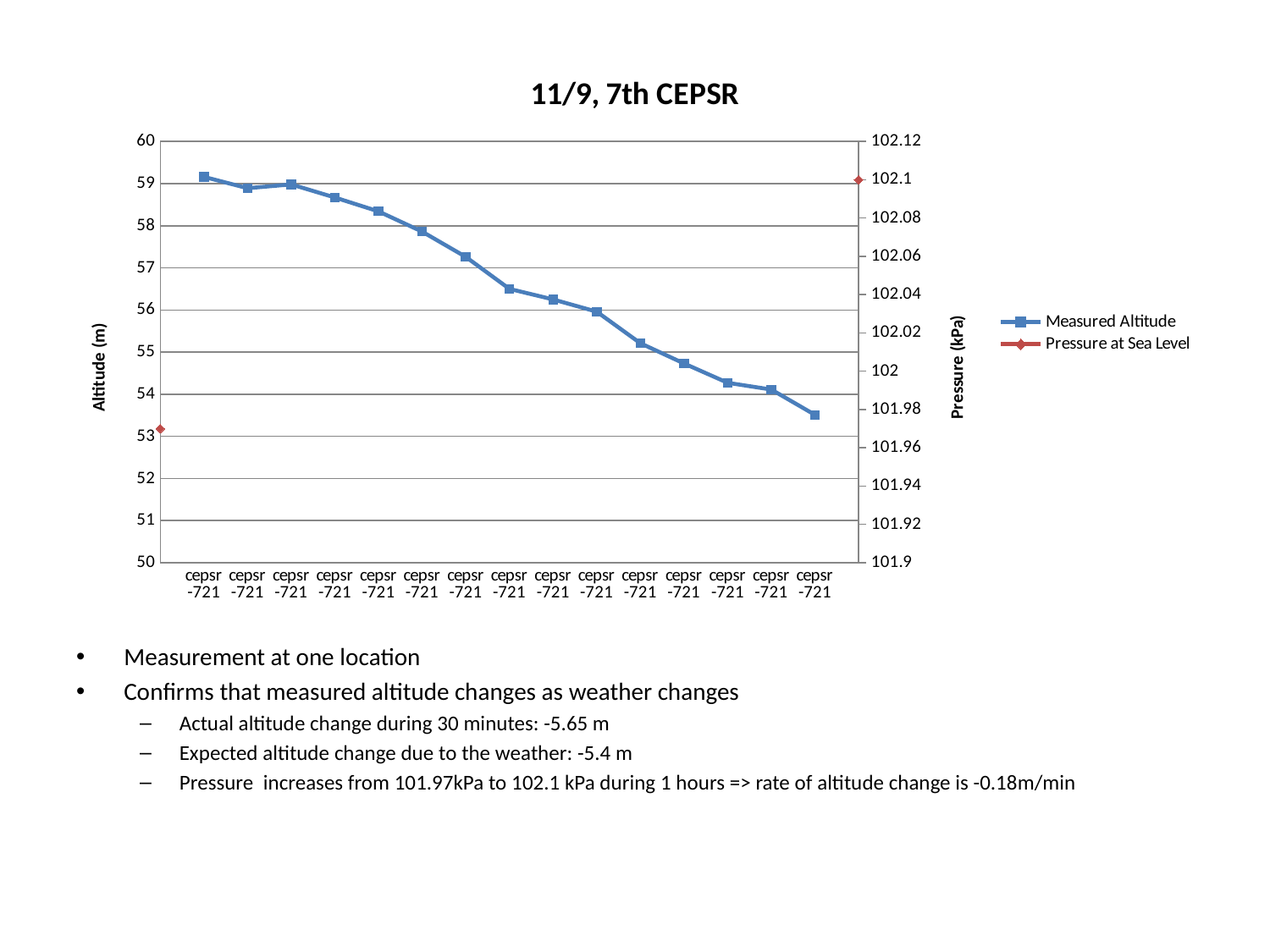
Is the last Measured Altitude value greater or less than 54? less What is the title of the chart? 11/9, 7th CEPSR Is the first Pressure at Sea Level value greater or less than 102 kPa? less Which point of the Measured Altitude series is the lowest, the first or the last? the last What are the two series named in the legend? Measured Altitude, Pressure at Sea Level Does the Measured Altitude series rise or fall from left to right along the x axis? fall What kind of chart is shown on the slide? line chart How many data points are plotted for the Measured Altitude series? 15 Which point of the Measured Altitude series is the highest, the first or the last? the first Is the first Measured Altitude value greater or less than 58? greater How many series does the legend list? 2